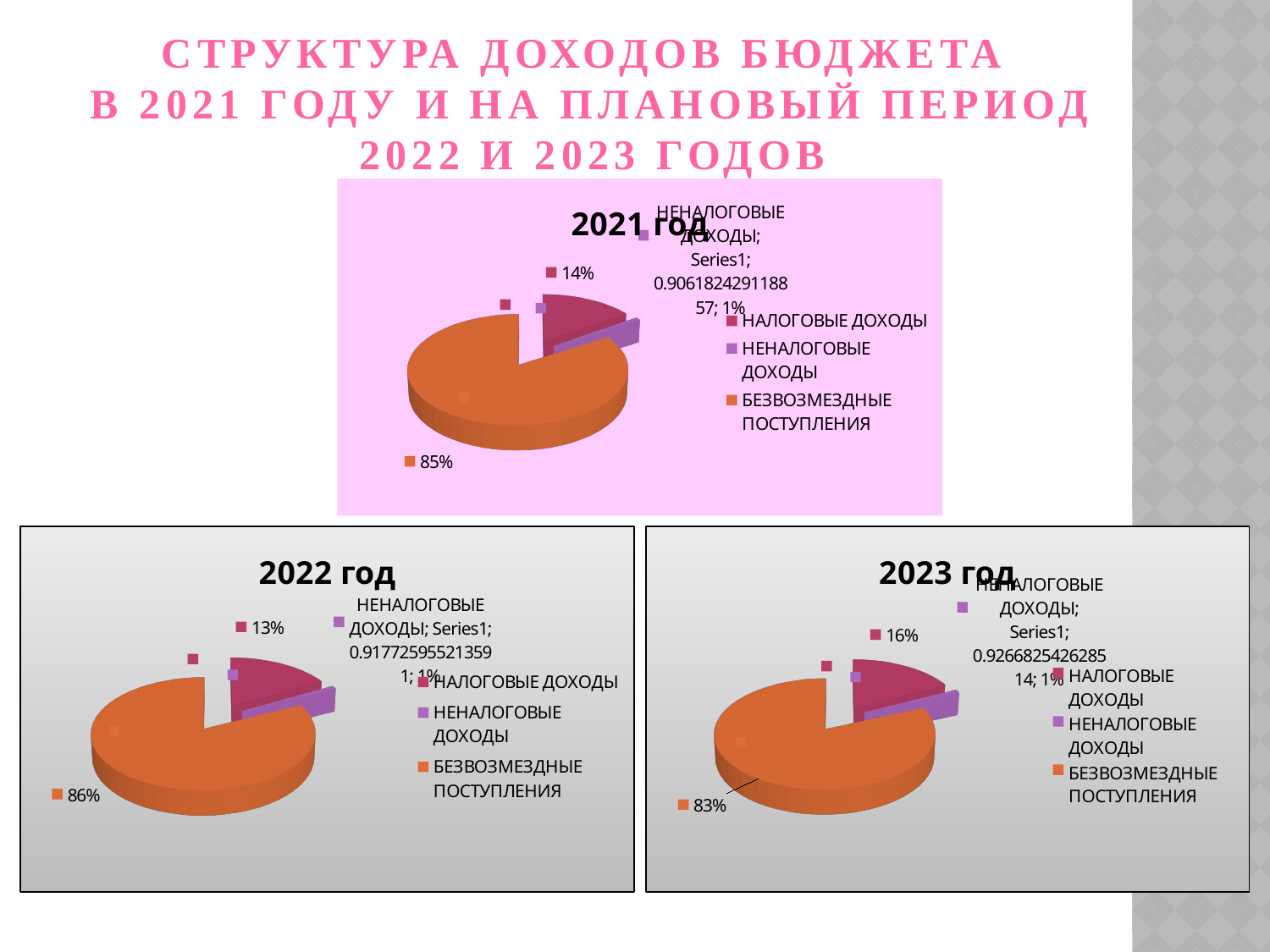
In the "2022 год" chart, what share is shown for БЕЗВОЗМЕЗДНЫЕ ПОСТУПЛЕНИЯ? 86% How many categories does the legend of the "2023 год" chart list? 3 What kind of chart is used for the "2021 год" chart? pie chart In the "2023 год" chart, which category has the largest slice? БЕЗВОЗМЕЗДНЫЕ ПОСТУПЛЕНИЯ In the "2022 год" chart, what share is shown for НАЛОГОВЫЕ ДОХОДЫ? 13% In the "2021 год" chart, what share is shown for БЕЗВОЗМЕЗДНЫЕ ПОСТУПЛЕНИЯ? 85% In the "2021 год" chart, what share is shown for НАЛОГОВЫЕ ДОХОДЫ? 14% In the "2023 год" chart, what share is shown for БЕЗВОЗМЕЗДНЫЕ ПОСТУПЛЕНИЯ? 83% Which is larger in the "2023 год" chart: the share for НАЛОГОВЫЕ ДОХОДЫ or the share for НЕНАЛОГОВЫЕ ДОХОДЫ? НАЛОГОВЫЕ ДОХОДЫ In the "2023 год" chart, what share is shown for НАЛОГОВЫЕ ДОХОДЫ? 16% In the "2021 год" chart, what is the difference in percentage points between БЕЗВОЗМЕЗДНЫЕ ПОСТУПЛЕНИЯ and НАЛОГОВЫЕ ДОХОДЫ? 71 In the "2022 год" chart, which category has the smallest slice? НЕНАЛОГОВЫЕ ДОХОДЫ